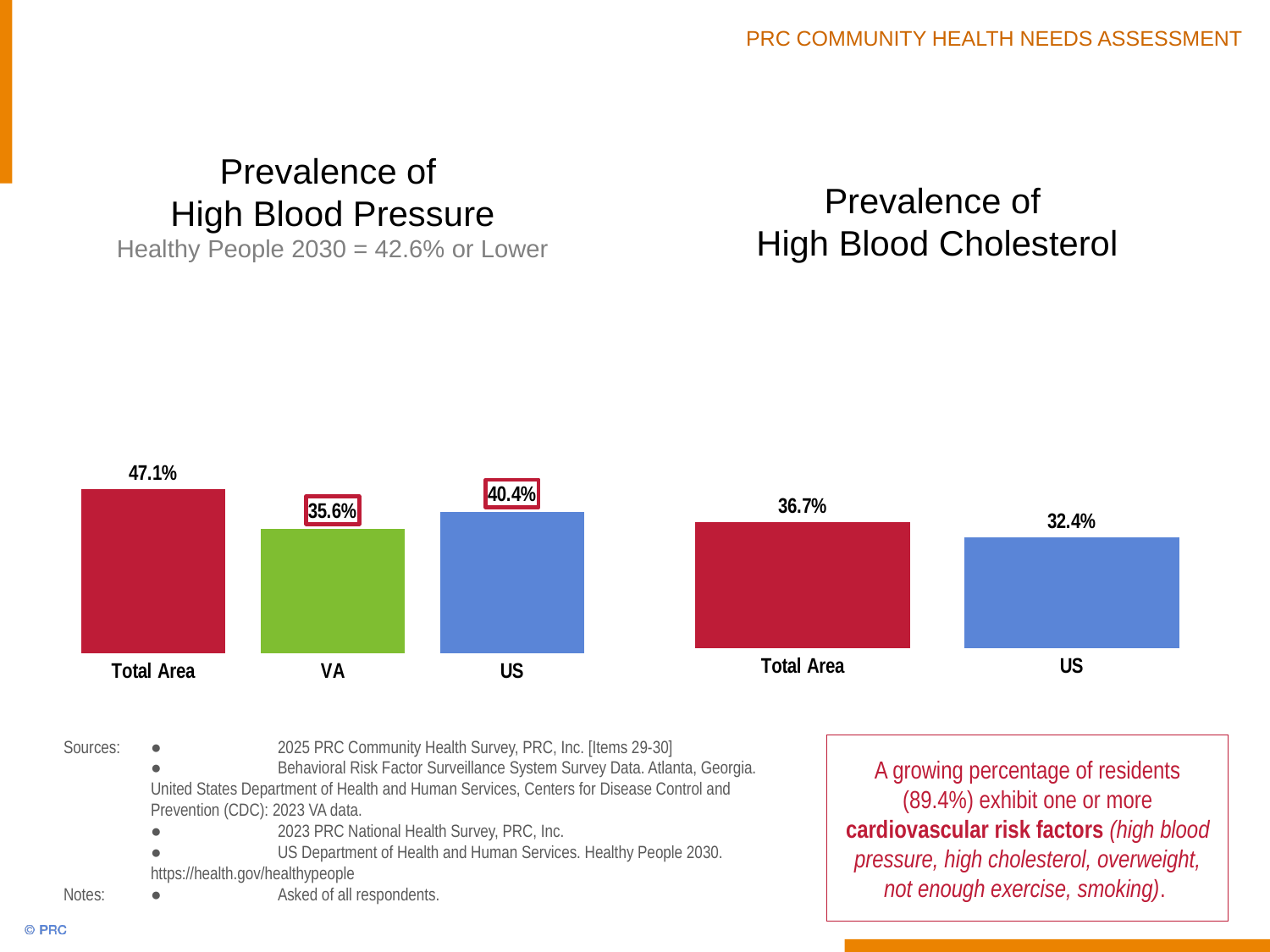
In the Prevalence of High Blood Cholesterol chart, what is the value for US? 32.4% In the Prevalence of High Blood Pressure chart, how many categories are shown? 3 What type of chart is the Prevalence of High Blood Cholesterol chart? Bar chart In the Prevalence of High Blood Cholesterol chart, what is the value for Total Area? 36.7% In the Prevalence of High Blood Pressure chart, what is the value for US? 40.4% In the Prevalence of High Blood Pressure chart, what is the value for VA? 35.6% In the Prevalence of High Blood Pressure chart, which category has the highest value? Total Area In the Prevalence of High Blood Pressure chart, what is the value for Total Area? 47.1% In the Prevalence of High Blood Cholesterol chart, which is larger, Total Area or US? Total Area In the Prevalence of High Blood Pressure chart, what is the difference between the Total Area and VA values? 11.5% In the Prevalence of High Blood Cholesterol chart, what is the difference between the Total Area and US values? 4.3% In the Prevalence of High Blood Pressure chart, which category has the lowest value? VA